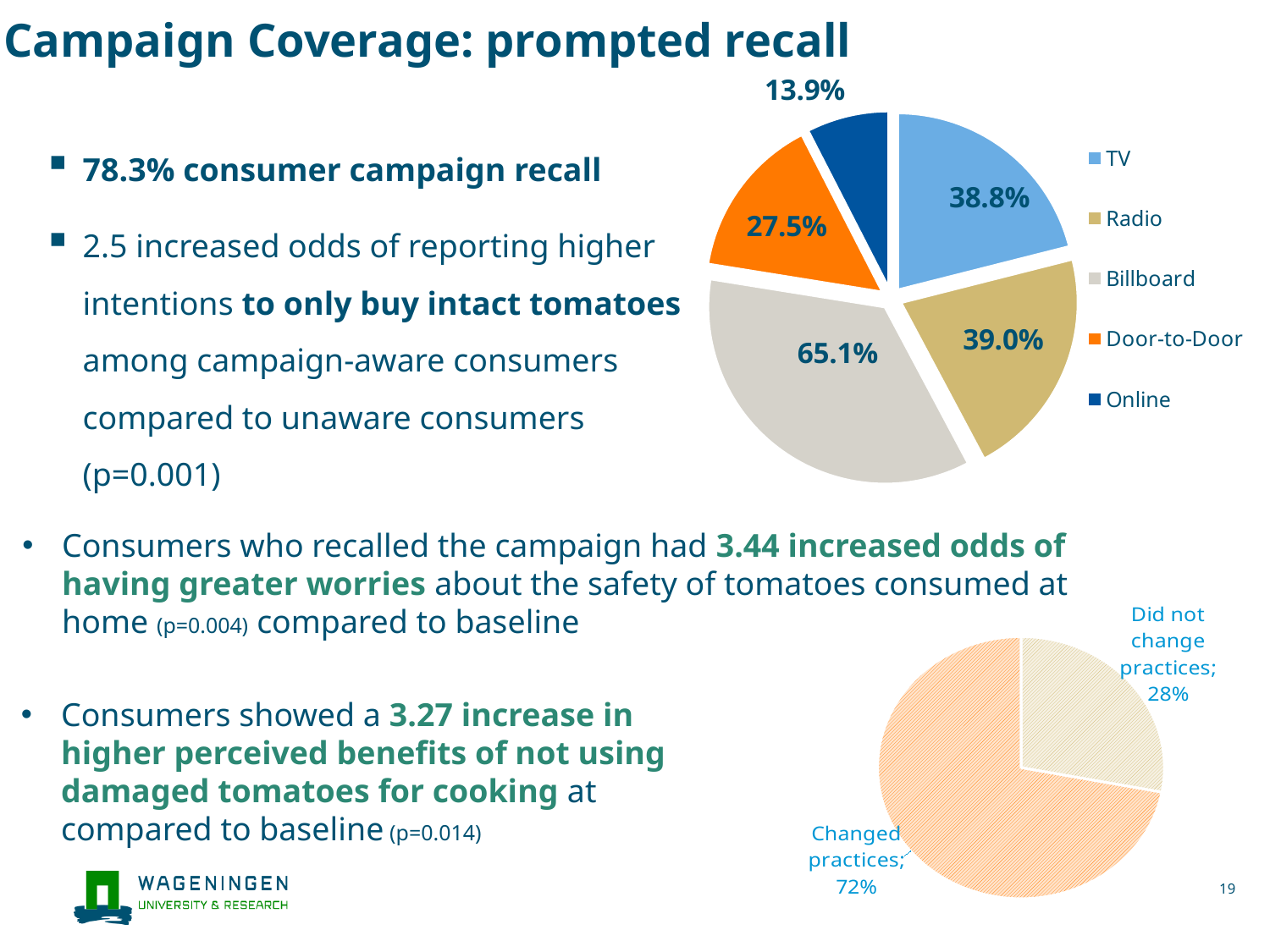
In the top-right pie chart, what is the value shown for Billboard? 65.1% In the top-right pie chart, what is the difference between the Billboard value and the Door-to-Door value? 37.6 percentage points How many entries does the legend of the top-right pie chart list? 5 In the top-right pie chart, which category has the highest value? Billboard In the top-right pie chart, which is larger, the value for Billboard or the value for Door-to-Door? Billboard How many slices does the bottom-right pie chart have? 2 In the bottom-right pie chart, what share is labelled 'Changed practices'? 72% In the top-right pie chart, what is the value shown for TV? 38.8% In the top-right pie chart, which category has the lowest value? Online In the bottom-right pie chart, what share is labelled 'Did not change practices'? 28% What type of chart is the top-right chart on the slide? pie chart In the top-right pie chart, what is the value shown for Door-to-Door? 27.5%